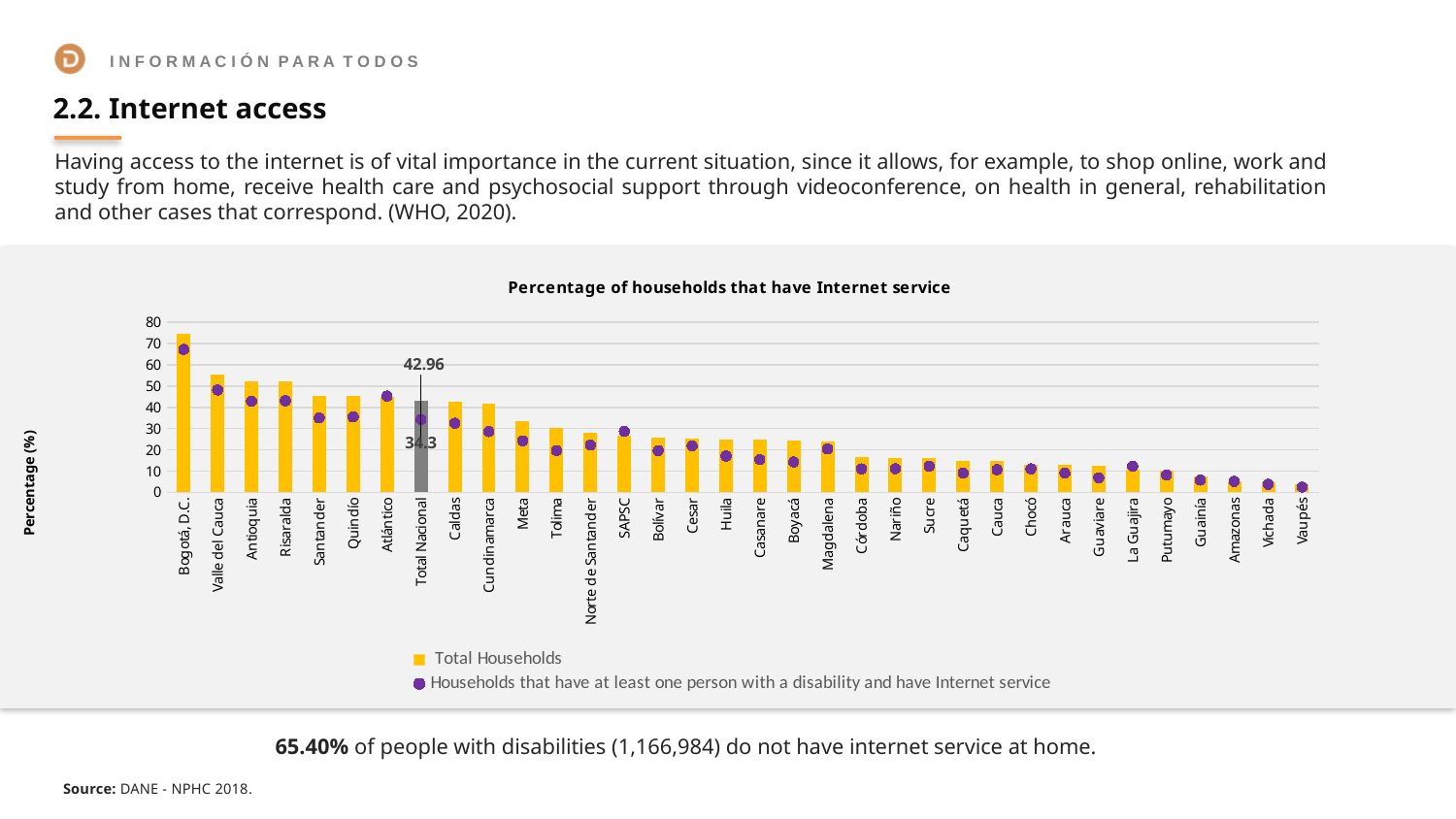
Is the Total Households value for Meta greater or less than 40? less How many series does the legend list? 2 Is the Total Households value for Bogotá, D.C. greater or less than 70? greater Which category has the highest Total Households percentage? Bogotá, D.C. What is the Total Households value shown for Total Nacional? 42.96 What is the difference between the Total Households value and the disability-household value for Total Nacional? 8.66 What is the value shown for households that have at least one person with a disability and have Internet service for Total Nacional? 34.3 Do the Total Households values rise or fall from left to right along the x axis? fall How many categories are shown on the x axis? 34 Which category has the lowest Total Households percentage? Vaupés What kind of chart is used to show the Total Households series? bar chart Which has a higher Total Households percentage, Antioquia or Meta? Antioquia